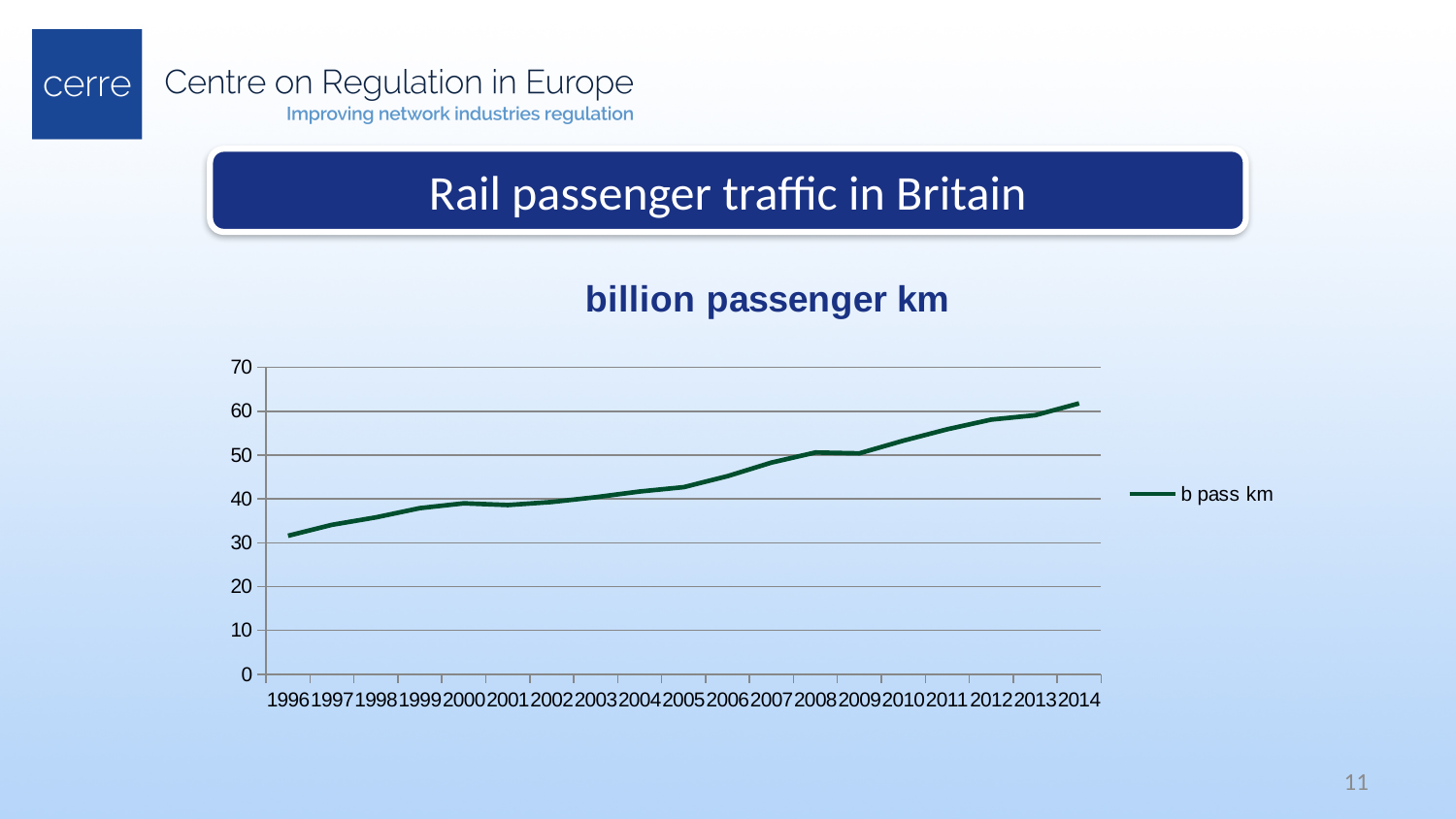
Is the value for 2008 greater or less than 40? greater What is the title of the chart? billion passenger km Do the values generally rise or fall from 1996 to 2014? rise How many series does the legend list? 1 Which year has the larger value, 2000 or 2010? 2010 What is the name of the series shown in the legend? b pass km How many years are plotted along the x axis? 19 Which year has the lowest value? 1996 Is the value for 2014 greater or less than 60? greater Is the value for 1996 greater or less than 40? less What kind of chart is shown on the slide? line chart Which year has the highest value? 2014